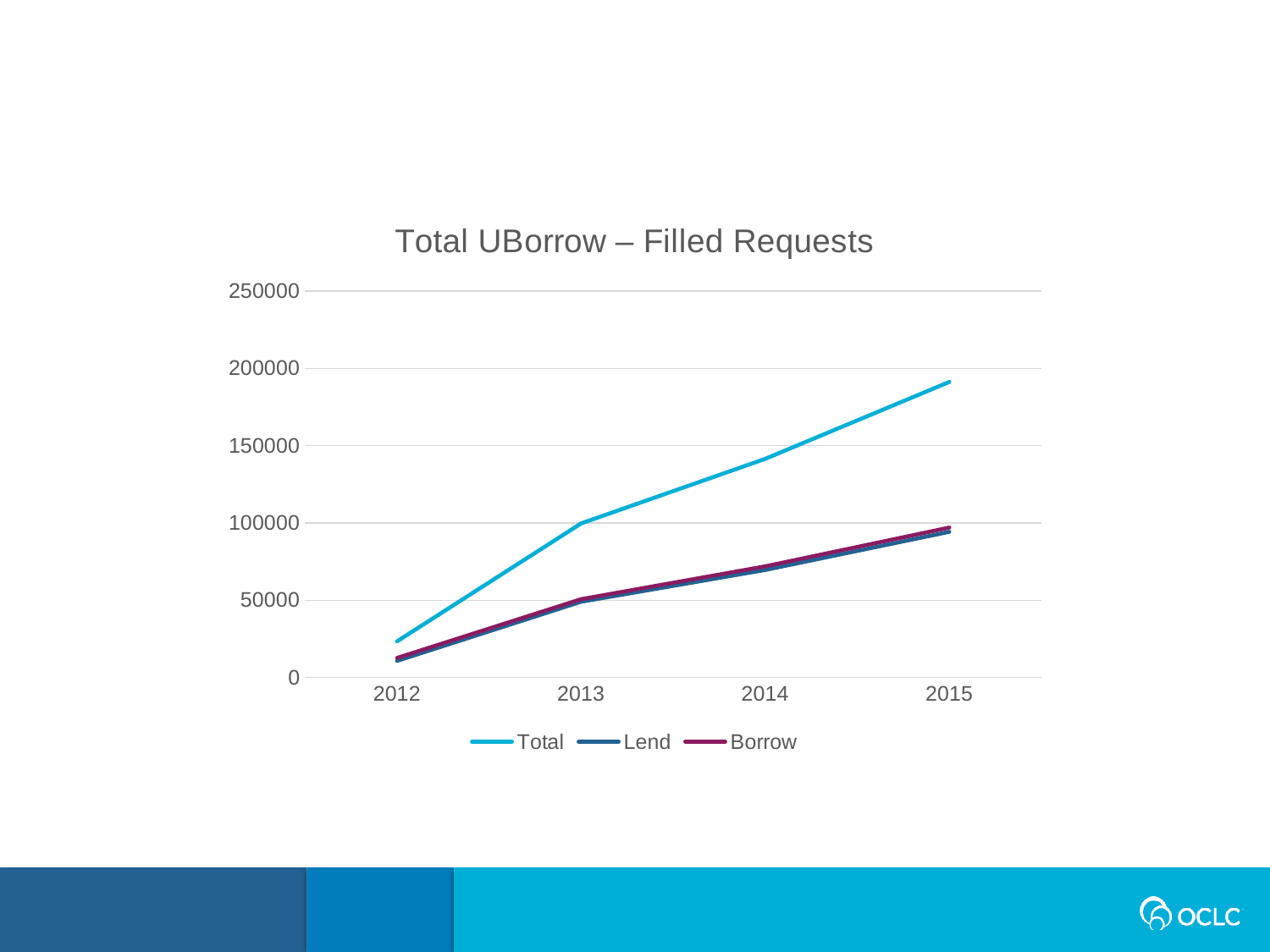
How many years are plotted along the x axis? 4 What kind of chart is shown on the slide? line chart Is the value for Lend in 2015 greater or less than 100000? less Does the Total series rise or fall from 2012 to 2015? rise What is the title of the chart? Total UBorrow – Filled Requests In which year is the Total series at its highest? 2015 In which year is the Total series at its lowest? 2012 Which series are listed in the legend? Total, Lend, Borrow Is the value for Total in 2015 greater or less than 150000? greater How many series does the legend list? 3 Is the value for Total in 2012 greater or less than 50000? less In 2015, which is larger, the Total series or the Lend series? Total